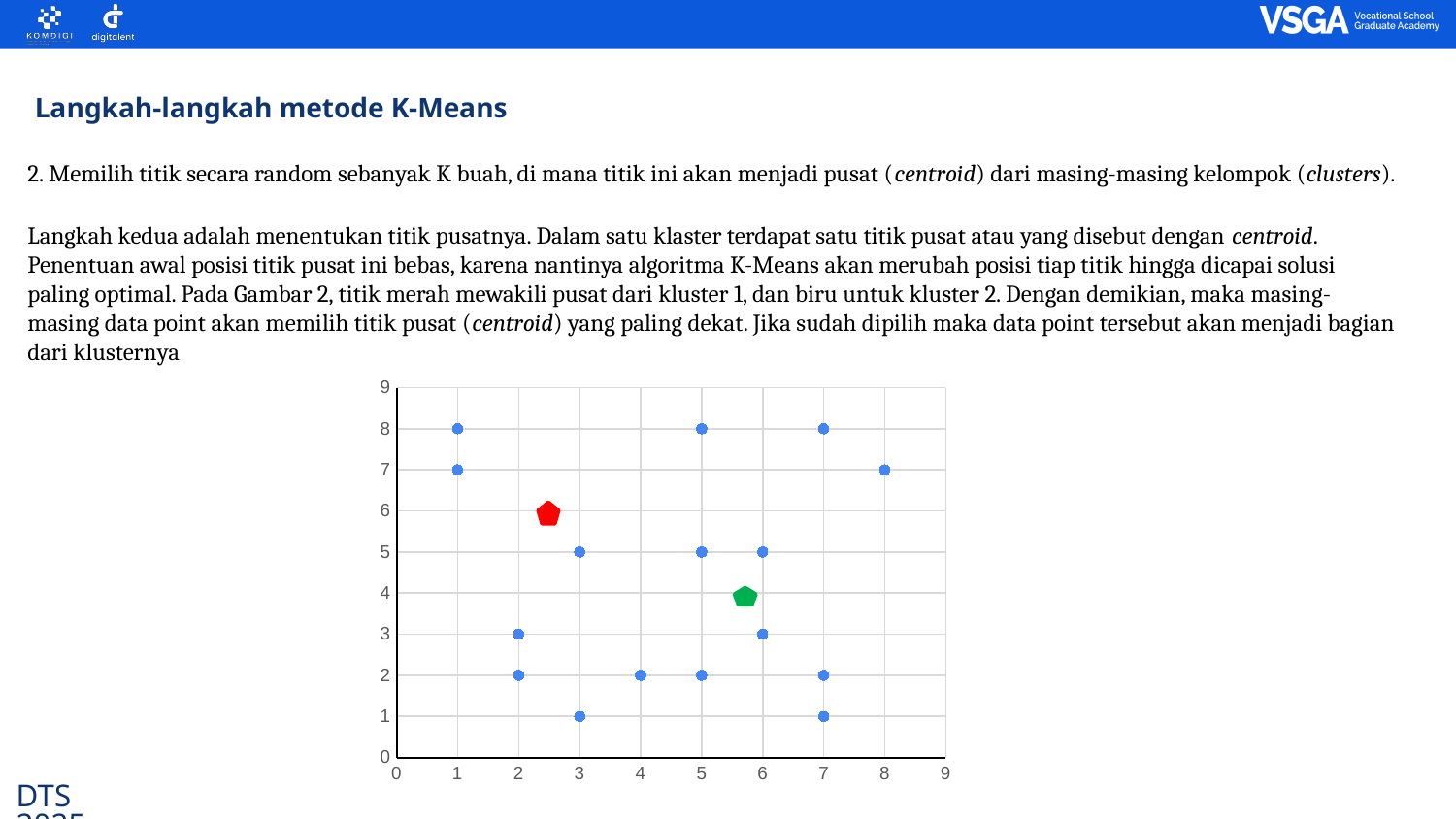
What kind of chart is shown on the slide? scatter plot What is the y value of the blue point plotted at x = 8? 7 How many blue data points are plotted on the chart? 16 Which blue point has the largest x value? the point at (8, 7) How many blue points are plotted at y = 8? 3 What is the y value of the blue point plotted at x = 4? 2 Is the y value of the red pentagon greater or less than 5? greater What is the maximum value shown on the x axis of the chart? 9 Is the y value of the green pentagon greater or less than 5? less Is the x value of the red pentagon greater or less than 3? less What colours are the two pentagon-shaped centroid markers on the chart? red and green How many blue points are plotted at x = 7? 3